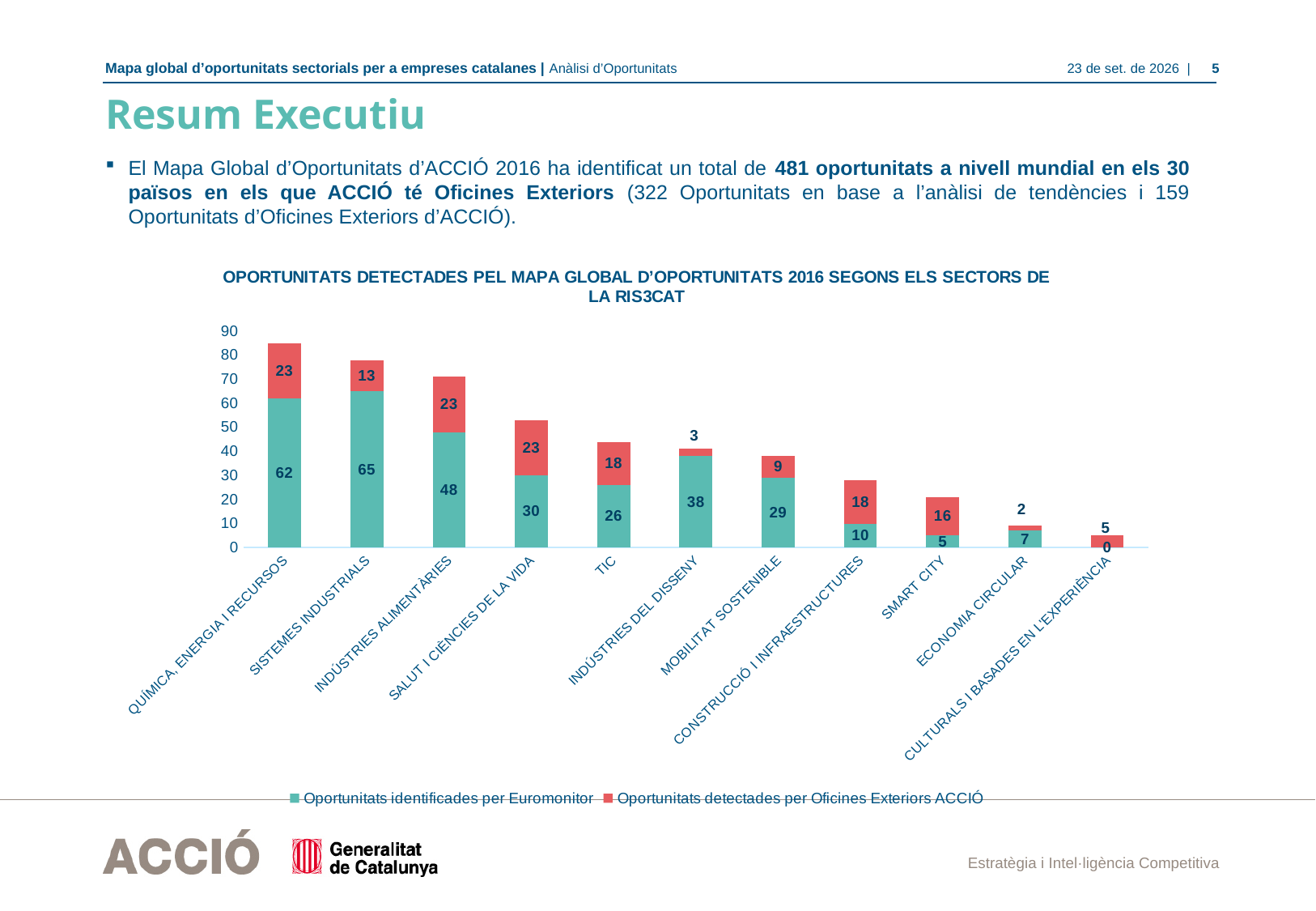
Which sector has the highest value for Oportunitats identificades per Euromonitor? SISTEMES INDUSTRIALS What is the value of Oportunitats identificades per Euromonitor for SISTEMES INDUSTRIALS? 65 What kind of chart is shown on the slide? Stacked bar chart How many sector categories are plotted on the x axis? 11 What is the total of the stacked bar for QUÍMICA, ENERGIA I RECURSOS? 85 How many series does the legend list? 2 Do the total bar heights rise or fall from left to right along the x axis? Fall Which colour represents Oportunitats detectades per Oficines Exteriors ACCIÓ in the chart? Red What is the value of Oportunitats detectades per Oficines Exteriors ACCIÓ for SMART CITY? 16 What is the difference between the Euromonitor values for INDÚSTRIES ALIMENTÀRIES and SALUT I CIÈNCIES DE LA VIDA? 18 Which sector has the lowest value for Oportunitats detectades per Oficines Exteriors ACCIÓ? ECONOMIA CIRCULAR For CONSTRUCCIÓ I INFRAESTRUCTURES, which is larger: Oportunitats identificades per Euromonitor or Oportunitats detectades per Oficines Exteriors ACCIÓ? Oportunitats detectades per Oficines Exteriors ACCIÓ